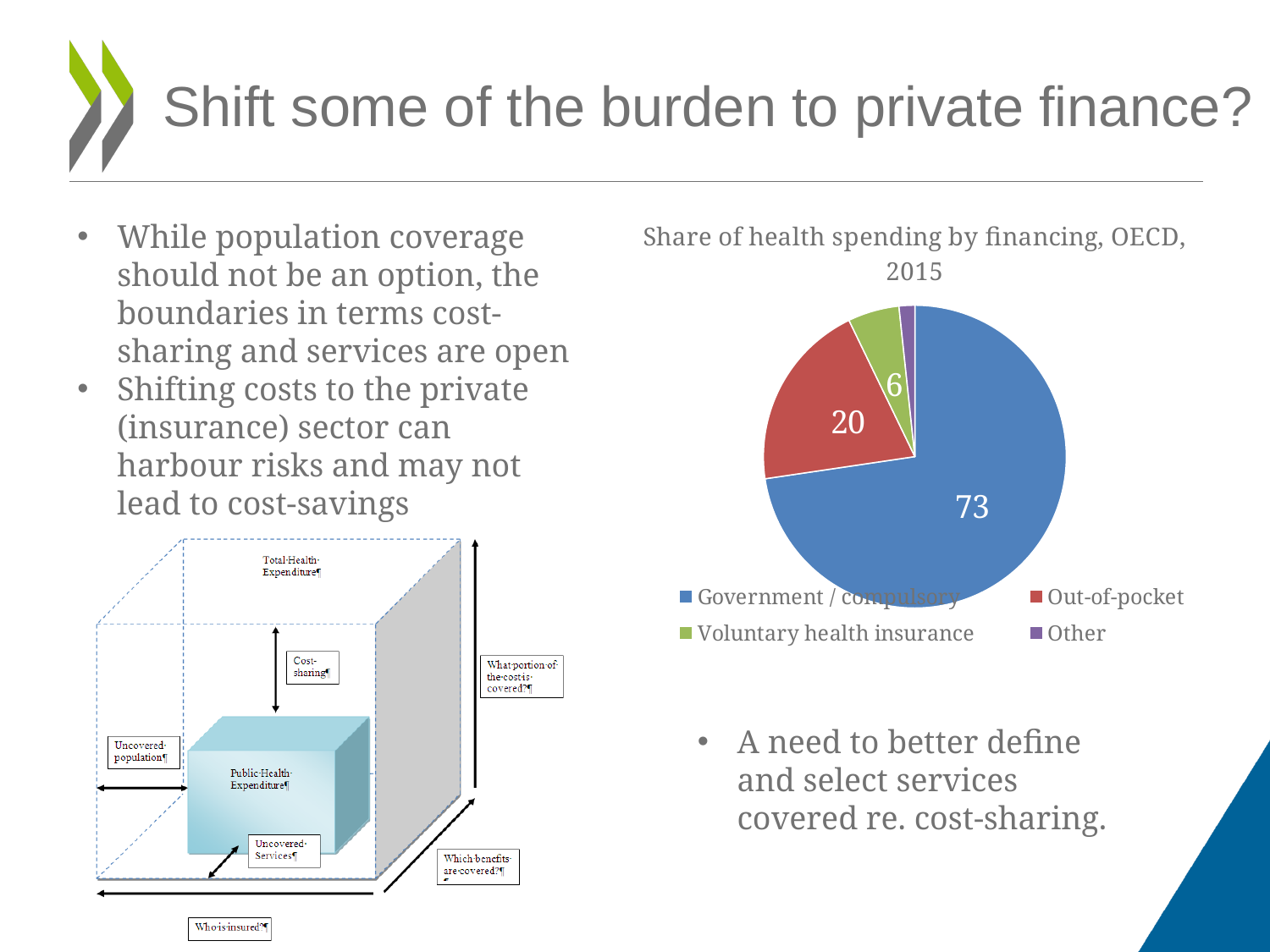
What kind of chart is shown on the right side of the slide? Pie chart What is the title of the pie chart? Share of health spending by financing, OECD, 2015 Which financing category has the largest share of health spending in the pie chart? Government / compulsory What is the difference between the Out-of-pocket value and the Voluntary health insurance value in the pie chart? 14 What is the value shown for the Voluntary health insurance slice in the pie chart? 6 How many categories does the pie chart show? 4 Which is larger in the pie chart, Out-of-pocket or Voluntary health insurance? Out-of-pocket How many entries does the pie chart's legend list? 4 What is the difference between the Government / compulsory value and the Out-of-pocket value in the pie chart? 53 Which financing category has the smallest slice in the pie chart? Other What is the value shown for the Out-of-pocket slice in the pie chart? 20 What is the value shown for the Government / compulsory slice in the pie chart? 73